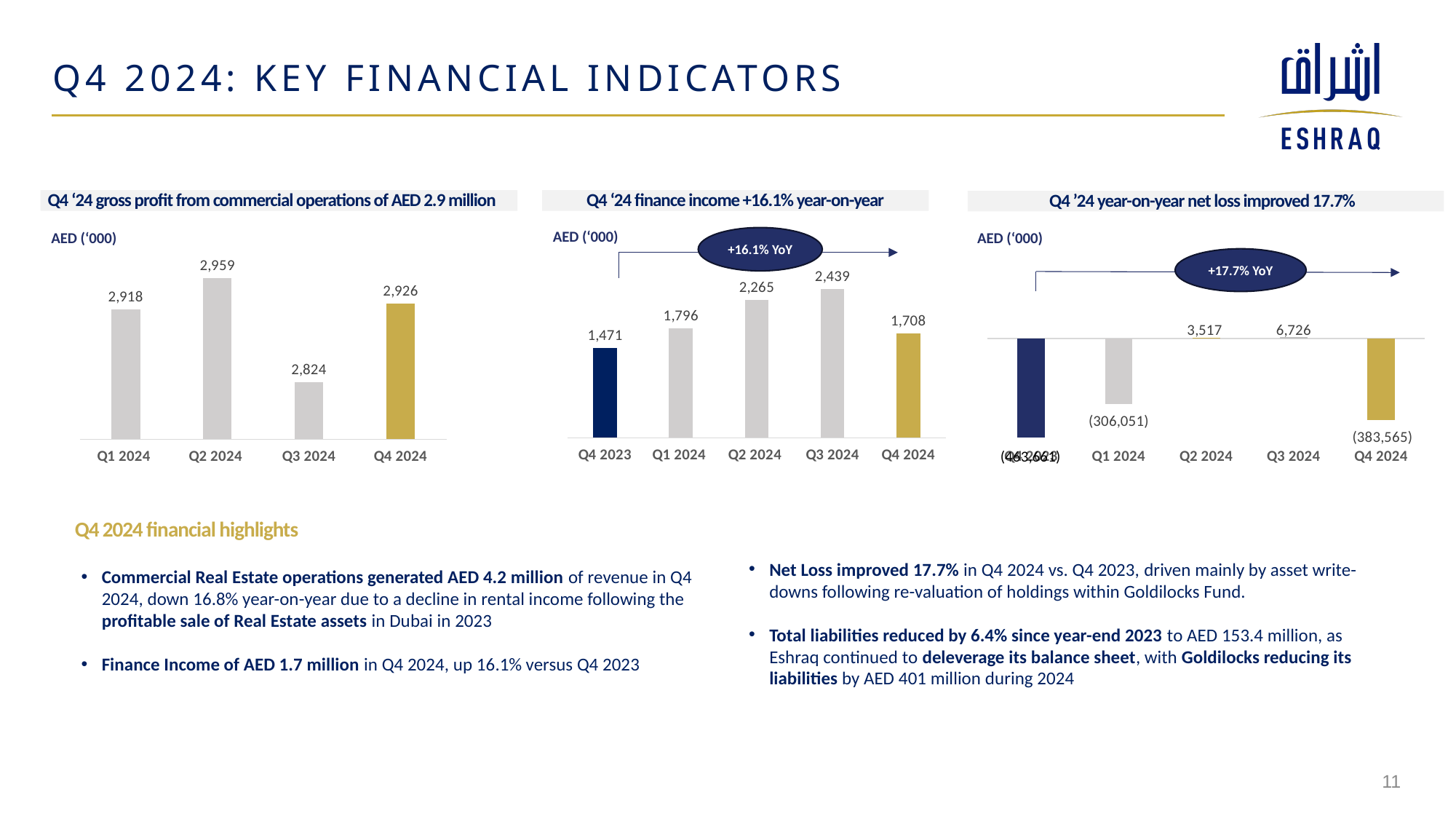
In the gross profit from commercial operations chart, what is the value for Q2 2024? 2,959 In the net loss chart, what is the value for Q1 2024? (306,051) In the net loss chart, what is the value for Q3 2024? 6,726 In the finance income chart, what is the value for Q4 2023? 1,471 In the finance income chart, what is the difference between Q4 2024 and Q4 2023? 237 In the gross profit from commercial operations chart, how many quarters are plotted? 4 In the finance income chart, which is larger, Q1 2024 or Q4 2024? Q1 2024 In the finance income chart, which quarter has the highest value? Q3 2024 In the finance income chart, how many bars are plotted? 5 In the gross profit from commercial operations chart, what is the difference between Q2 2024 and Q3 2024? 135 What type of chart is used for the finance income data? Bar chart In the gross profit from commercial operations chart, which quarter has the lowest value? Q3 2024